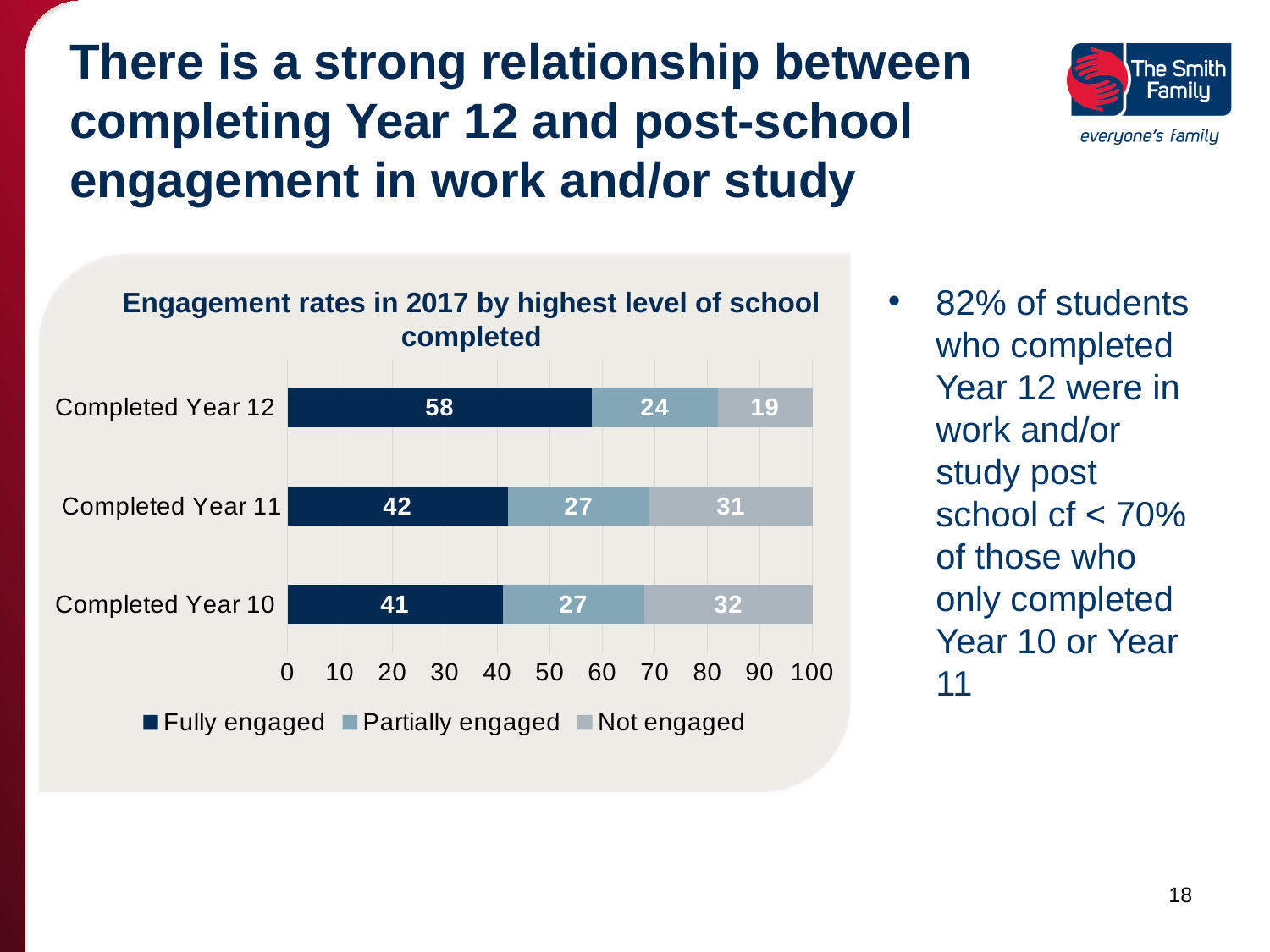
How many categories are shown on the chart? 3 Which category has the highest Fully engaged value? Completed Year 12 What is the difference between the Fully engaged values for Completed Year 12 and Completed Year 10? 17 What kind of chart is shown on the slide? Stacked bar chart What is the Fully engaged value for Completed Year 12? 58 What is the total of the stacked bar for Completed Year 11? 100 What is the Partially engaged value for Completed Year 10? 27 How many series does the legend list? 3 Is the Not engaged value larger for Completed Year 10 or Completed Year 12? Completed Year 10 Which category has the lowest Not engaged value? Completed Year 12 What is the title of the chart? Engagement rates in 2017 by highest level of school completed What is the Not engaged value for Completed Year 11? 31